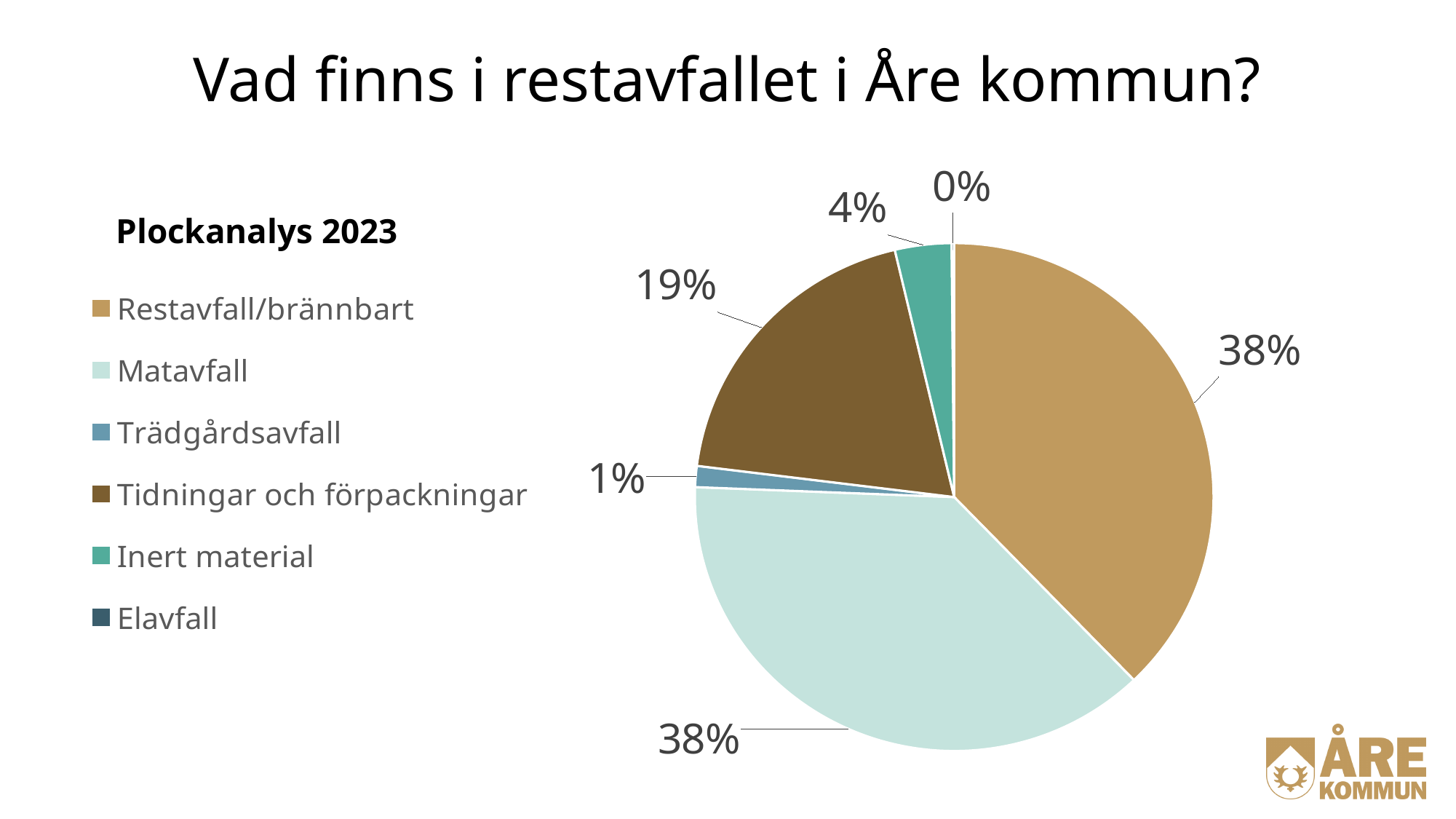
What share of the pie does Matavfall represent? 38% How many categories does the legend list? 6 What is the value shown for Tidningar och förpackningar? 19% Which category is shown in the light teal colour in the legend? Matavfall What is the title of the chart? Plockanalys 2023 Which is larger, Tidningar och förpackningar or Inert material? Tidningar och förpackningar What is the value shown for Inert material? 4% What is the value shown for Elavfall? 0% What kind of chart is shown on the slide? Pie chart What is the difference in percentage points between Tidningar och förpackningar and Inert material? 15 What is the value shown for Trädgårdsavfall? 1% Which category has the smallest share of the pie? Elavfall